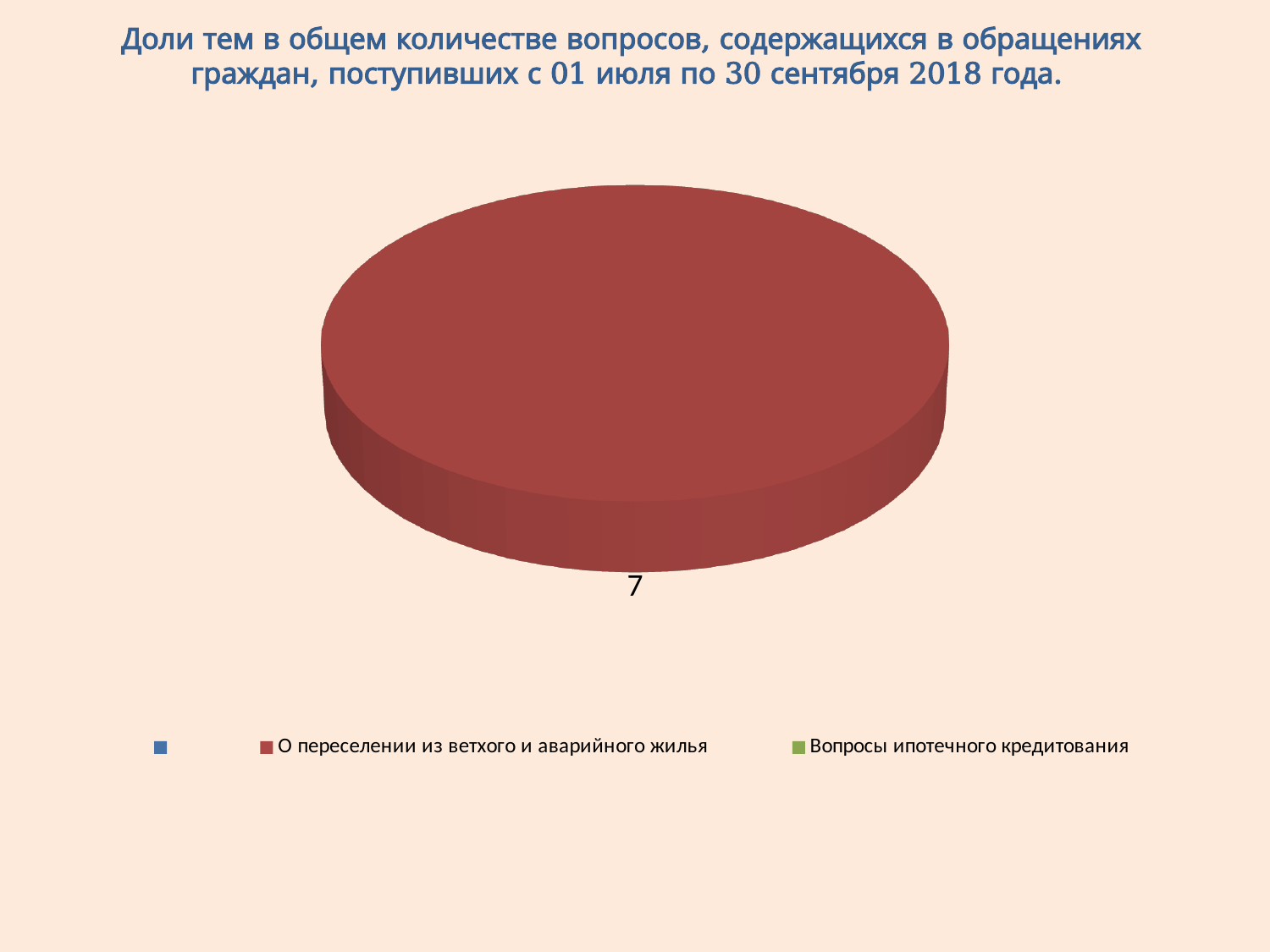
What kind of chart is shown on the slide? Pie chart What value is printed on the slice for "О переселении из ветхого и аварийного жилья"? 7 What is the only data label printed on the pie chart? 7 Which category accounts for the largest share of the pie? О переселении из ветхого и аварийного жилья How many entries does the legend list? 3 What colour is the legend marker for "Вопросы ипотечного кредитования"? Green What colour is the slice for "О переселении из ветхого и аварийного жилья"? Red How many slices are visibly plotted in the pie? 1